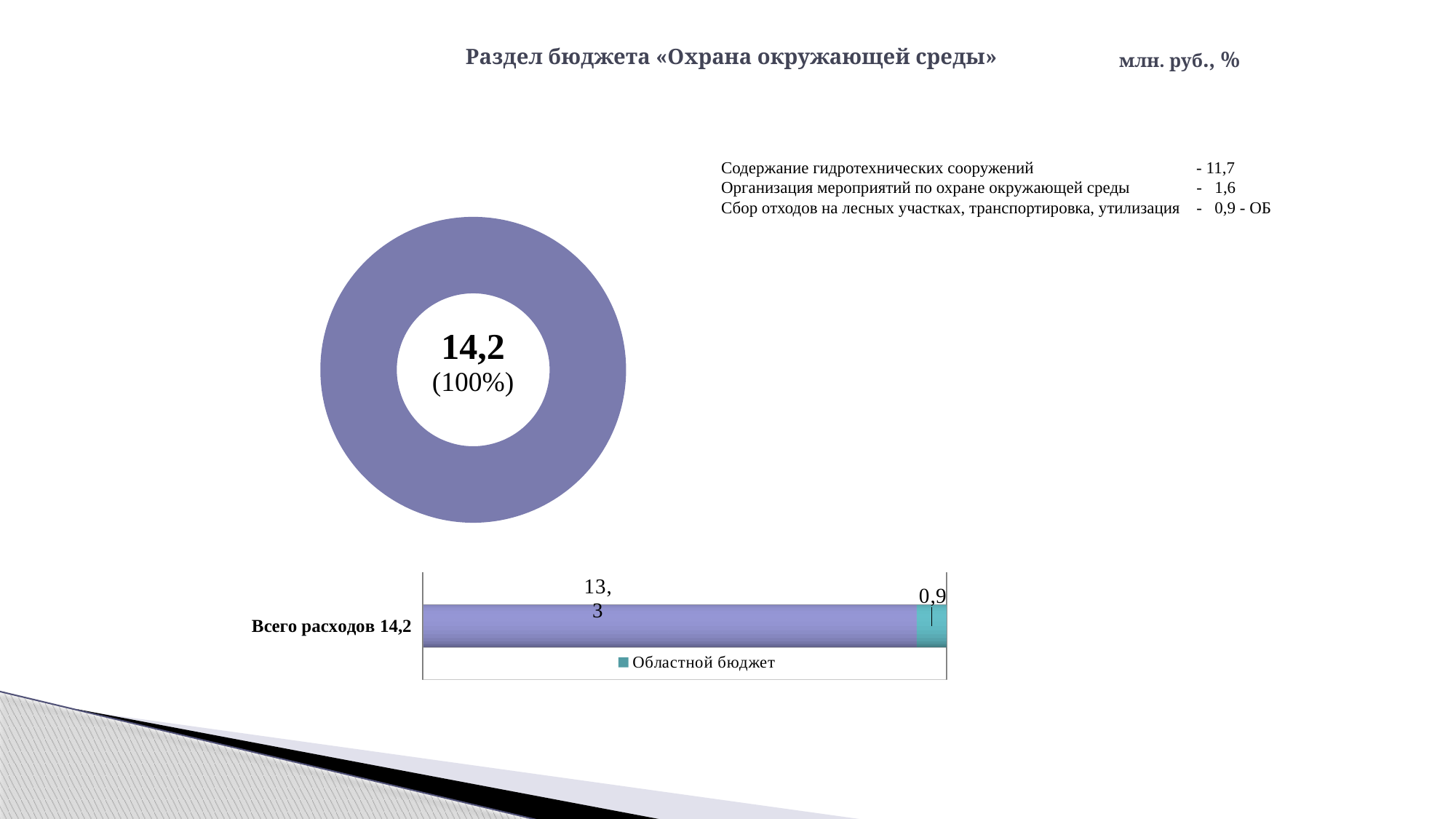
What is the legend entry shown under the bar chart 'Всего расходов 14,2'? Областной бюджет What percentage is shown in the centre of the doughnut chart? 100% What kind of chart is the chart at the top left of the slide? doughnut chart In the bar chart 'Всего расходов 14,2', what is the difference between the two segments, 13,3 and 0,9? 12,4 How many bars (categories) does the bar chart 'Всего расходов 14,2' show? 1 In the bar chart 'Всего расходов 14,2', what is the value of the 'Областной бюджет' (teal) segment? 0,9 In the bar chart 'Всего расходов 14,2', what is the total of the stacked bar? 14,2 In the bar chart 'Всего расходов 14,2', what is the value of the larger (purple) segment? 13,3 In the bar chart 'Всего расходов 14,2', which segment is larger, the purple one or the 'Областной бюджет' one? the purple one (13,3) How many entries does the legend of the bar chart 'Всего расходов 14,2' list? 1 What kind of chart is the chart at the bottom of the slide labelled 'Всего расходов 14,2'? bar chart What value is printed in the centre of the doughnut chart? 14,2